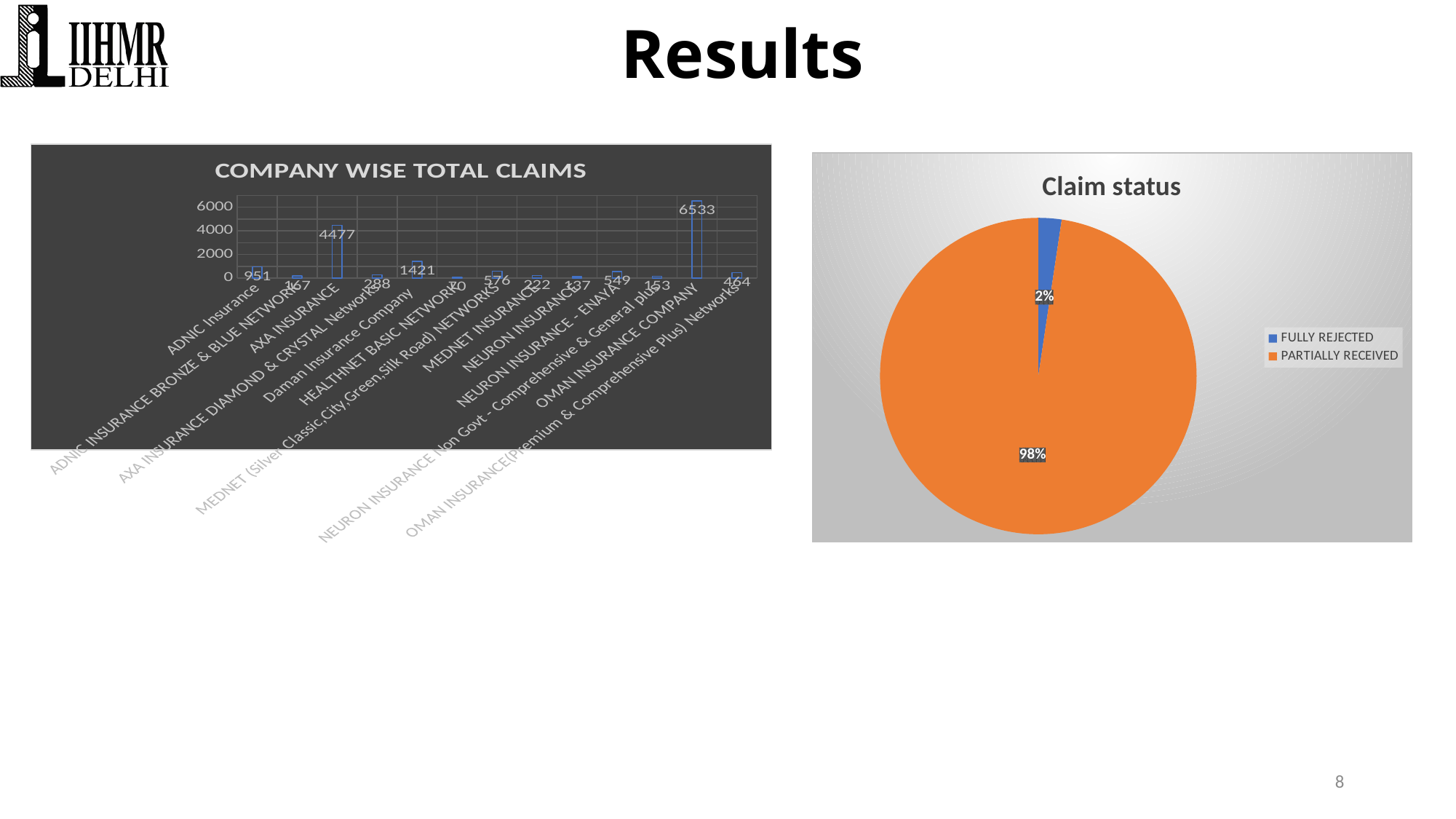
In the COMPANY WISE TOTAL CLAIMS chart, what is the value for OMAN INSURANCE COMPANY? 6533 In the COMPANY WISE TOTAL CLAIMS chart, which is larger: Daman Insurance Company or AXA INSURANCE? AXA INSURANCE How many entries does the legend of the Claim status chart list? 2 In the COMPANY WISE TOTAL CLAIMS chart, what is the value for Daman Insurance Company? 1421 In the Claim status chart, what share of claims were PARTIALLY RECEIVED? 98% In the COMPANY WISE TOTAL CLAIMS chart, which company has the highest total claims? OMAN INSURANCE COMPANY What kind of chart is the COMPANY WISE TOTAL CLAIMS chart? bar chart In the COMPANY WISE TOTAL CLAIMS chart, what is the difference between OMAN INSURANCE COMPANY and AXA INSURANCE? 2056 In the COMPANY WISE TOTAL CLAIMS chart, is the value for AXA INSURANCE greater or less than 4000? greater In the COMPANY WISE TOTAL CLAIMS chart, what is the value for AXA INSURANCE? 4477 In the Claim status chart, what share of claims were FULLY REJECTED? 2% How many companies are shown in the COMPANY WISE TOTAL CLAIMS chart? 13